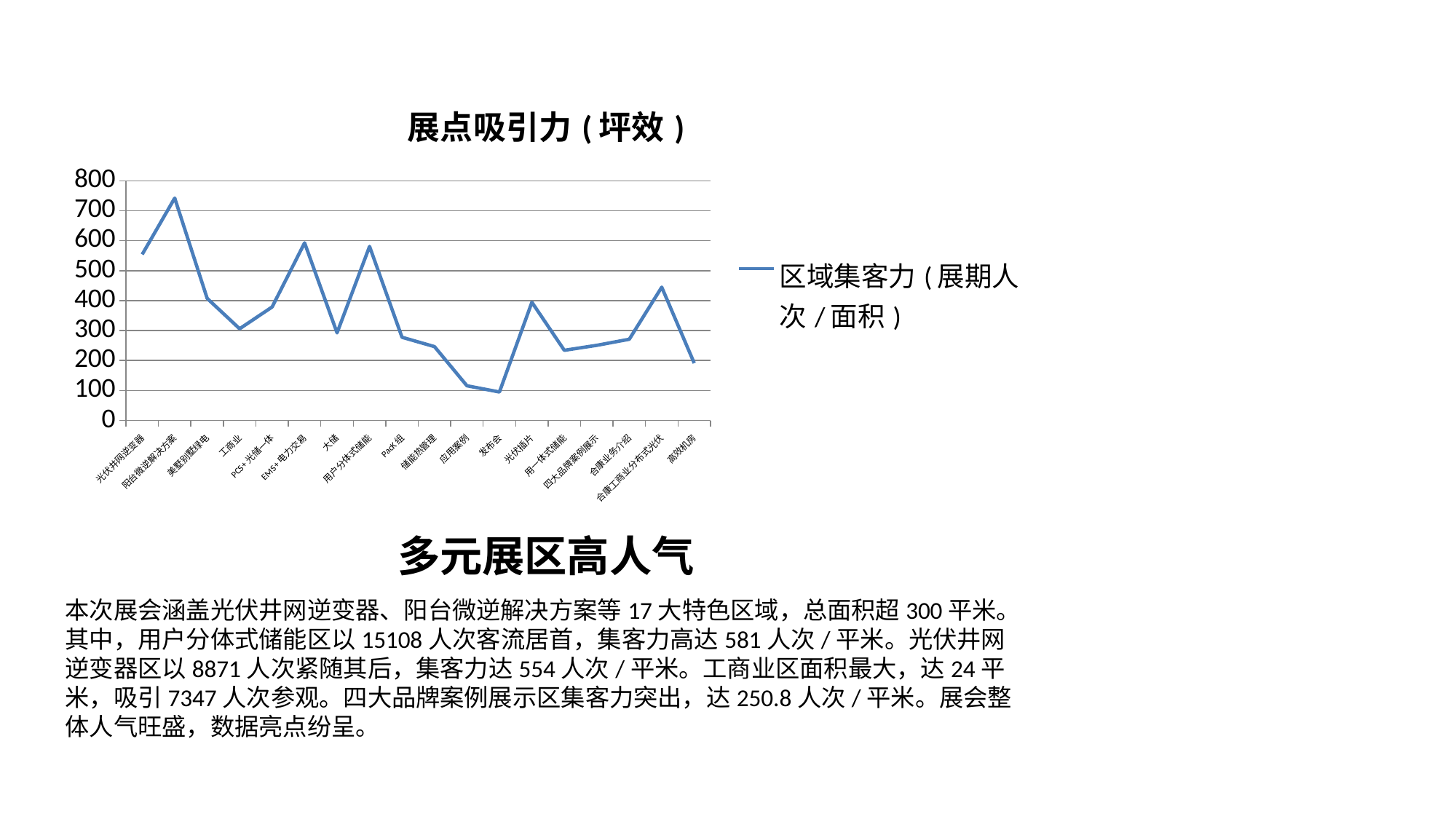
Is the value for 阳台微逆解决方案 greater or less than 700? greater Which category has the highest value on the chart? 阳台微逆解决方案 Which category has the lowest value on the chart? 发布会 Do the values rise or fall from 储能热管理 to 发布会? fall Which is larger, the value for 用户分体式储能 or the value for 大储? 用户分体式储能 What kind of chart is shown on the slide? line chart How many series does the legend list? 1 Is the value for 应用案例 greater or less than 200? less What is the title of the chart? 展点吸引力（坪效） Is the value for 用户分体式储能 greater or less than 500? greater What is the name of the series shown in the legend? 区域集客力（展期人次/面积）